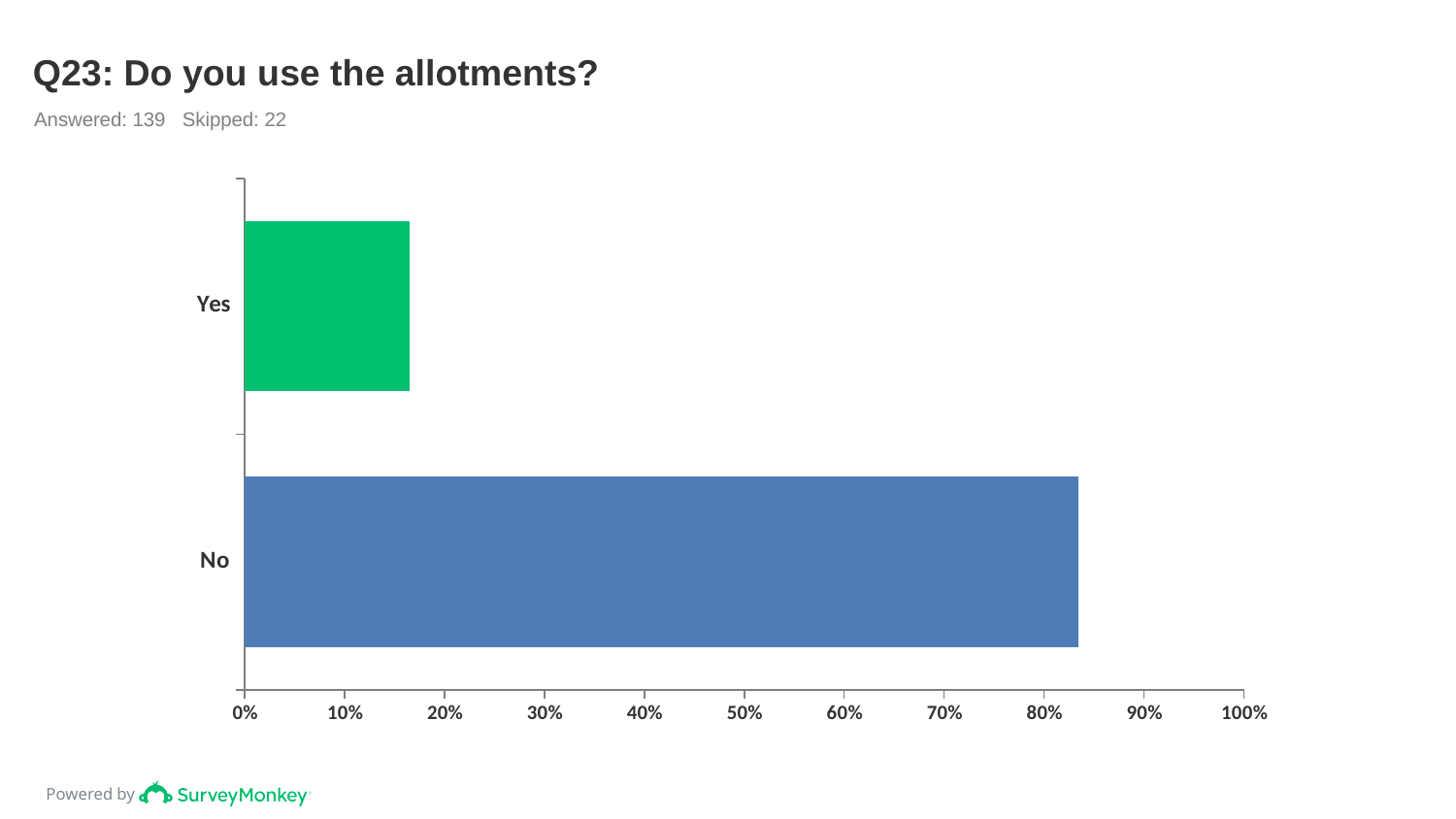
Is the value for Yes greater or less than 20%? less What colour is the bar for Yes? green Which category has the highest value? No Is the value for Yes greater or less than 10%? greater Which category has the lowest value? Yes What kind of chart is shown on the slide? bar chart Is the value for No greater or less than 90%? less How many categories are plotted in the chart? 2 Which is larger, the value for Yes or the value for No? No What is the title of the chart? Q23: Do you use the allotments? What is the maximum value shown on the x axis? 100%